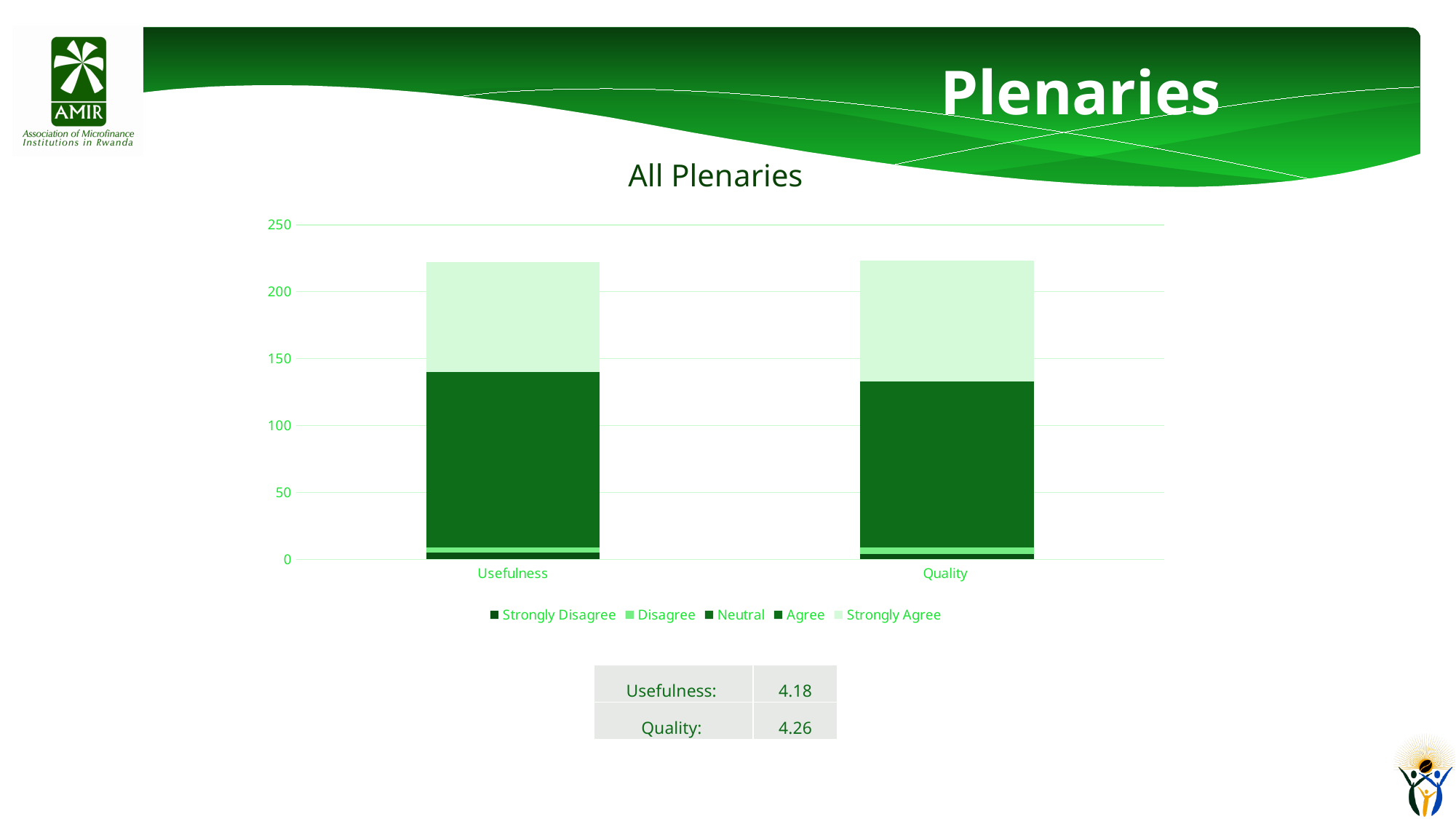
Is the total height of the stacked bar for Quality greater or less than 250? less Is the top of the Agree segment in the Usefulness bar greater or less than 150? less Is the top of the Agree segment in the Usefulness bar greater or less than 100? greater What is the title of the chart? All Plenaries Which series occupies the largest portion of the Quality bar? Agree How many series does the chart's legend list? 5 What kind of chart is shown on the slide? stacked bar chart How many categories are shown on the x axis of the chart? 2 Which series occupies the largest portion of the Usefulness bar? Agree Which series is listed last in the chart's legend? Strongly Agree